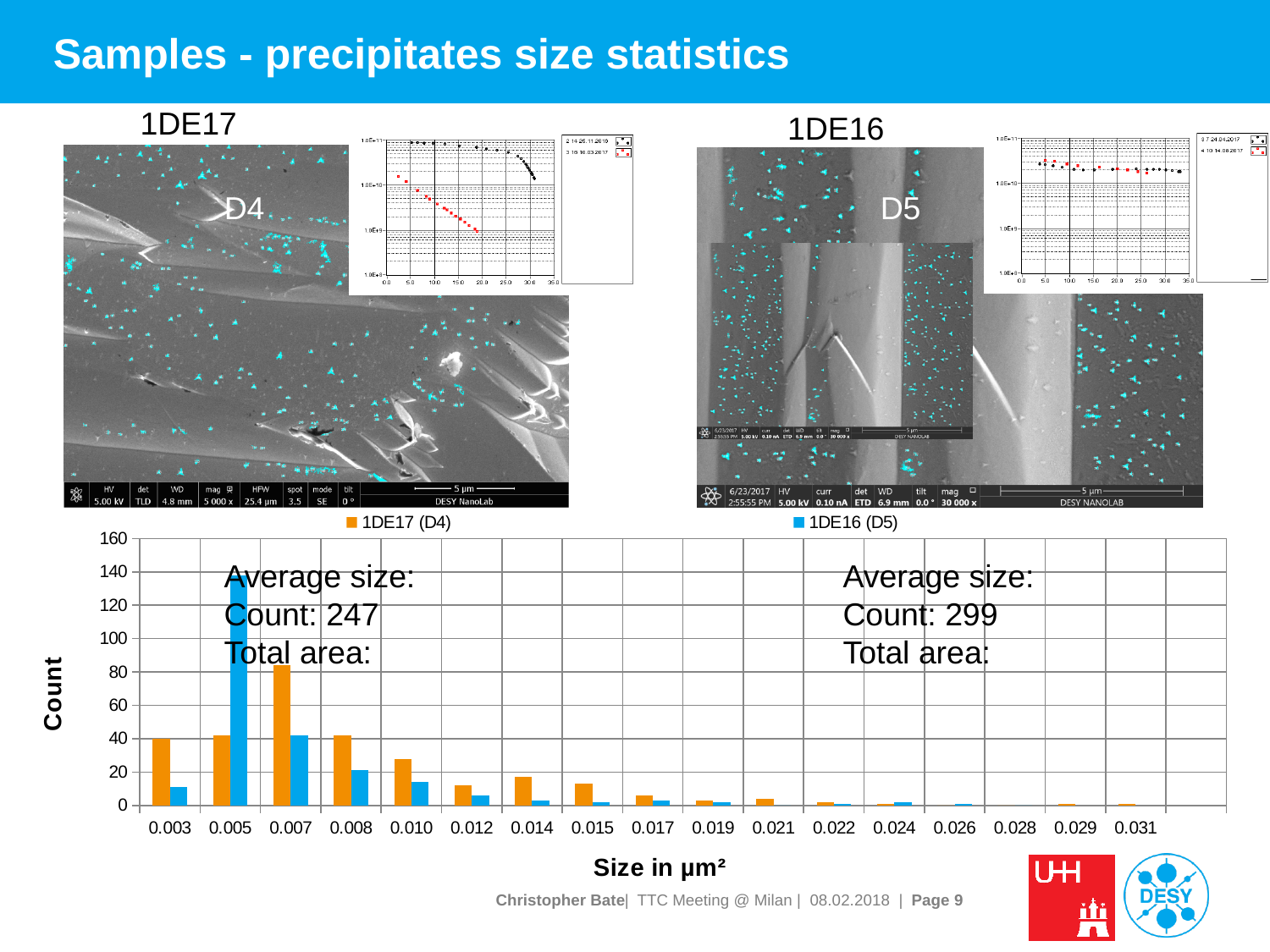
What is the x-axis title of the bottom bar chart? Size in µm² In the bottom bar chart, which series has the larger count at size 0.007, 1DE17 (D4) or 1DE16 (D5)? 1DE17 (D4) How many size categories are shown on the x axis of the bottom bar chart? 17 In the bottom bar chart, at which size does the 1DE17 (D4) series reach its highest count? 0.007 How many series does the legend of the bottom bar chart list? 2 In the bottom bar chart, which series has the larger count at size 0.005, 1DE17 (D4) or 1DE16 (D5)? 1DE16 (D5) In the bottom bar chart, is the 1DE16 (D5) count at size 0.003 greater or less than 20? less In the bottom bar chart, is the 1DE17 (D4) count at size 0.007 greater or less than 60? greater In the bottom bar chart, is the 1DE16 (D5) count at size 0.005 greater or less than 120? greater What are the two series named in the legend of the bottom bar chart? 1DE17 (D4) and 1DE16 (D5) What kind of chart is shown at the bottom of the slide? bar chart In the bottom bar chart, at which size does the 1DE16 (D5) series reach its highest count? 0.005